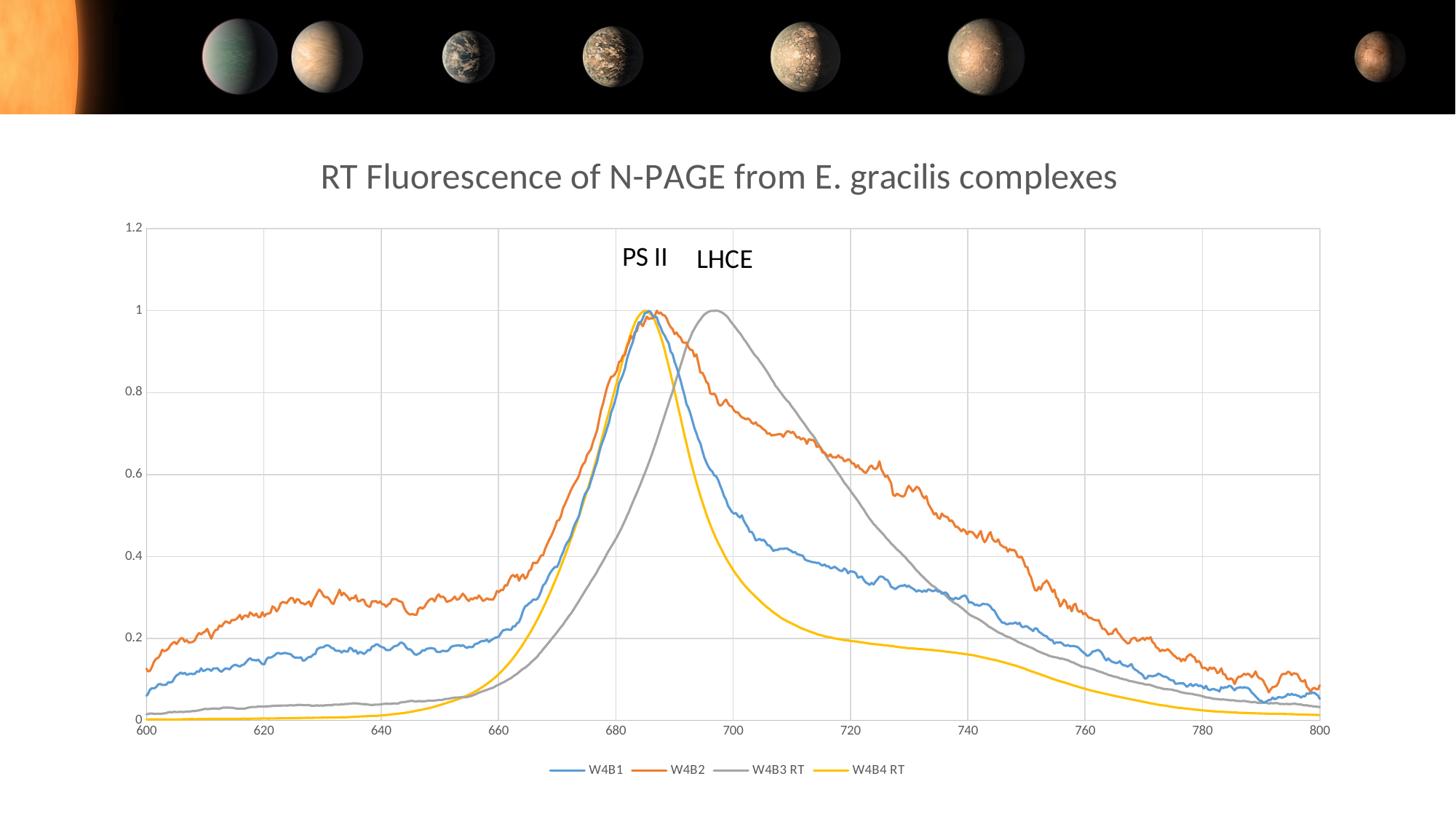
Which series reaches its peak at the longest wavelength on the x axis? W4B3 RT How many series does the legend list? 4 Is the value for W4B1 at 760 greater or less than 0.4? less Between 700 and 800 on the x axis, does the W4B2 series rise or fall? fall Is the value for W4B4 RT at 620 greater or less than 0.2? less What is the title of the chart? RT Fluorescence of N-PAGE from E. gracilis complexes At 640, which series has the higher value, W4B1 or W4B3 RT? W4B1 At 720, which series has the higher value, W4B2 or W4B4 RT? W4B2 Is the value for W4B2 at 620 greater or less than 0.2? greater What kind of chart is shown on the slide? line chart Which series are listed in the legend? W4B1, W4B2, W4B3 RT, W4B4 RT